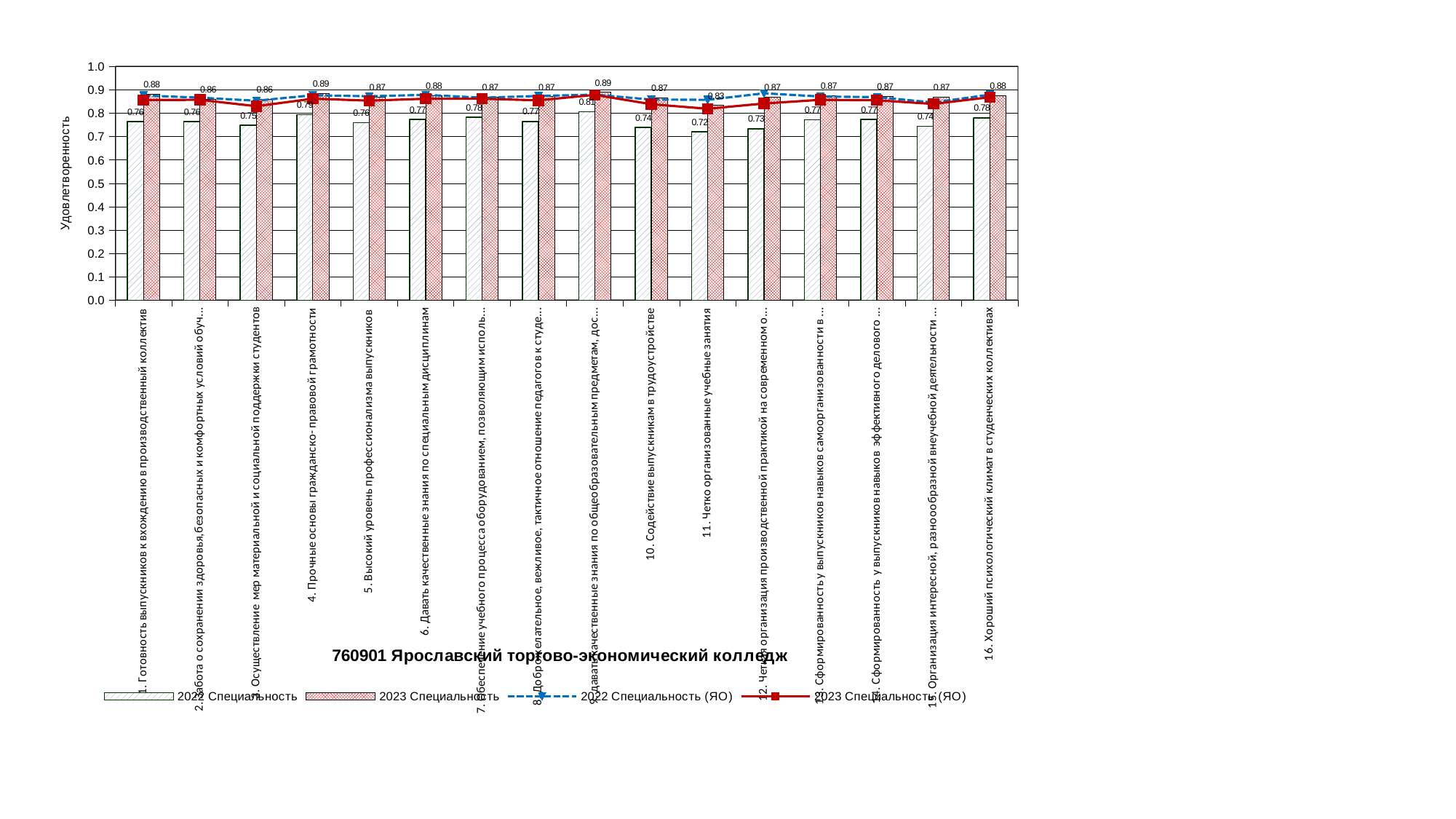
What kind of chart is shown on the slide? A bar chart combined with line series For "1. Готовность выпускников к вхождению в производственный коллектив", which is larger: the 2022 Специальность value or the 2023 Специальность value? 2023 Специальность Is the 2022 Специальность value for "10. Содействие выпускникам в трудоустройстве" greater or less than 0.8? less What is the 2023 Специальность value for "4. Прочные основы гражданско-правовой грамотности"? 0.89 How many series does the chart legend list? 4 Which category has the lowest 2023 Специальность value? 11. Четко организованные учебные занятия What is the title of the chart's vertical axis? Удовлетворенность What is the difference between the 2023 Специальность and 2022 Специальность values for "11. Четко организованные учебные занятия"? 0.11 What is the 2022 Специальность value for "11. Четко организованные учебные занятия"? 0.72 Which category has the lowest 2022 Специальность value? 11. Четко организованные учебные занятия What is the 2022 Специальность value for "16. Хороший психологический климат в студенческих коллективах"? 0.78 How many categories are plotted along the x axis of the chart? 16